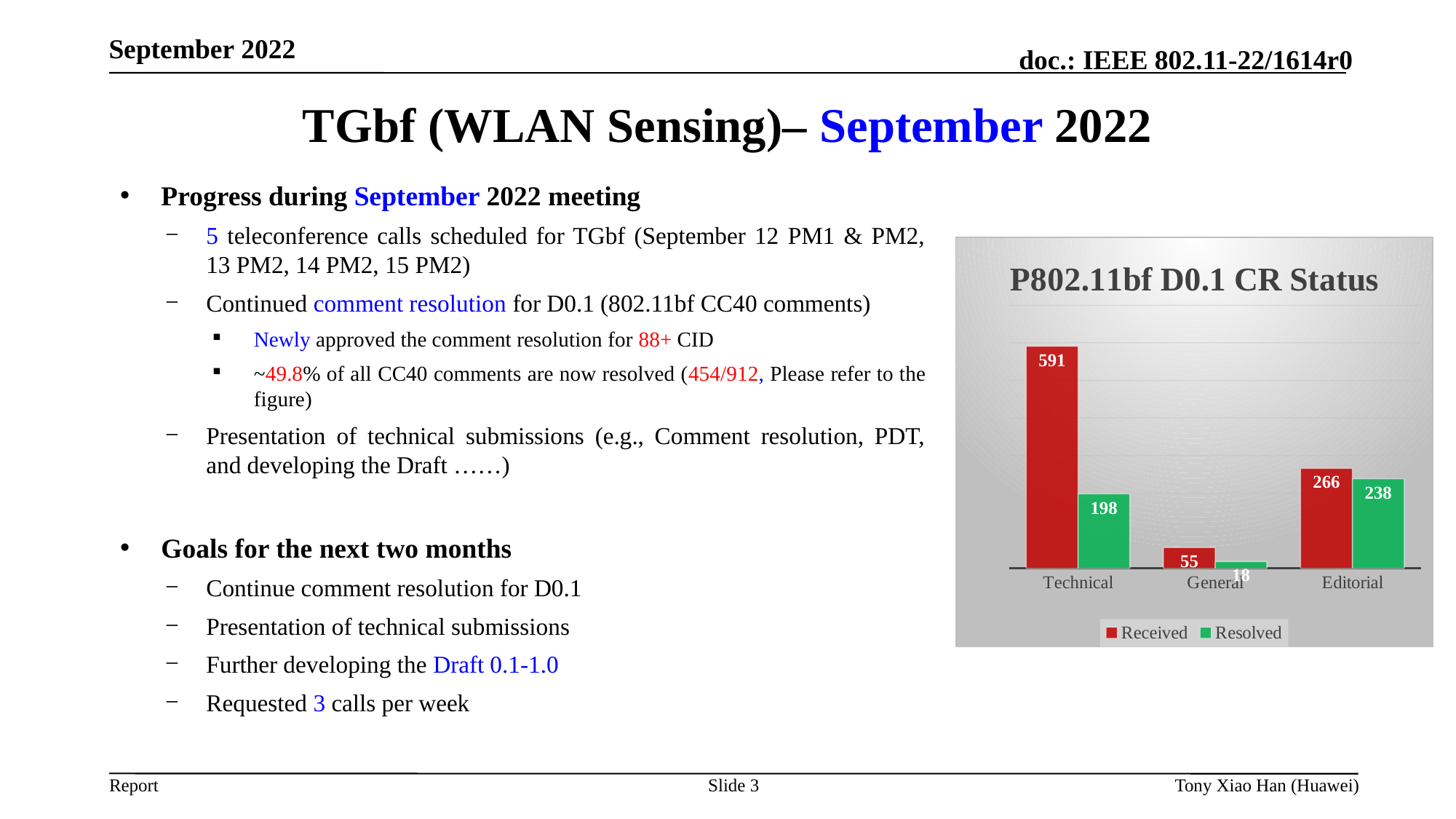
What type of chart is shown on the slide? bar chart What is the Received value for Technical? 591 How many series does the legend list? 2 What is the Received value for General? 55 Which is larger, the Resolved value for Technical or the Resolved value for Editorial? Editorial What is the difference between Received and Resolved for Technical? 393 Which category has the lowest Resolved value? General How many categories are shown on the x axis? 3 Which colour represents the Resolved series? green Which category has the highest Received value? Technical What is the title of the chart? P802.11bf D0.1 CR Status What is the Resolved value for Editorial? 238